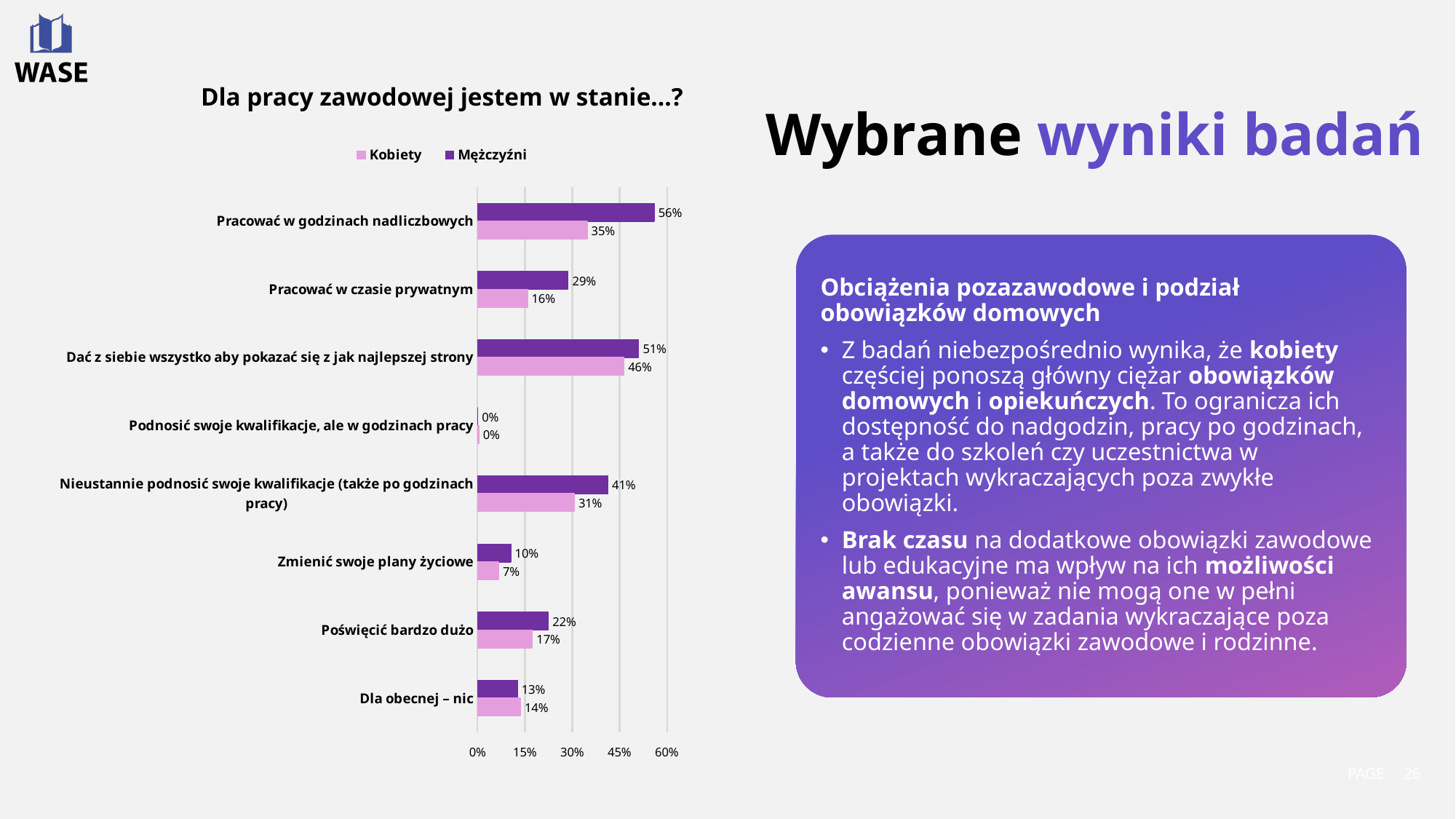
What is the value for Kobiety for "Dać z siebie wszystko aby pokazać się z jak najlepszej strony"? 46% Which category has the highest value for Mężczyźni? Pracować w godzinach nadliczbowych What kind of chart is shown on the slide? bar chart Is the Mężczyźni value for "Nieustannie podnosić swoje kwalifikacje (także po godzinach pracy)" greater or less than 30%? greater What is the value for Mężczyźni for "Pracować w godzinach nadliczbowych"? 56% How many series does the legend list? 2 What is the difference between the Mężczyźni and Kobiety values for "Pracować w godzinach nadliczbowych"? 21% What is the title of the chart? Dla pracy zawodowej jestem w stanie…? What is the value for Kobiety for "Pracować w czasie prywatnym"? 16% How many categories are shown on the chart? 8 For "Dla obecnej – nic", which series has the larger value, Kobiety or Mężczyźni? Kobiety Which category has the lowest value for Kobiety? Podnosić swoje kwalifikacje, ale w godzinach pracy